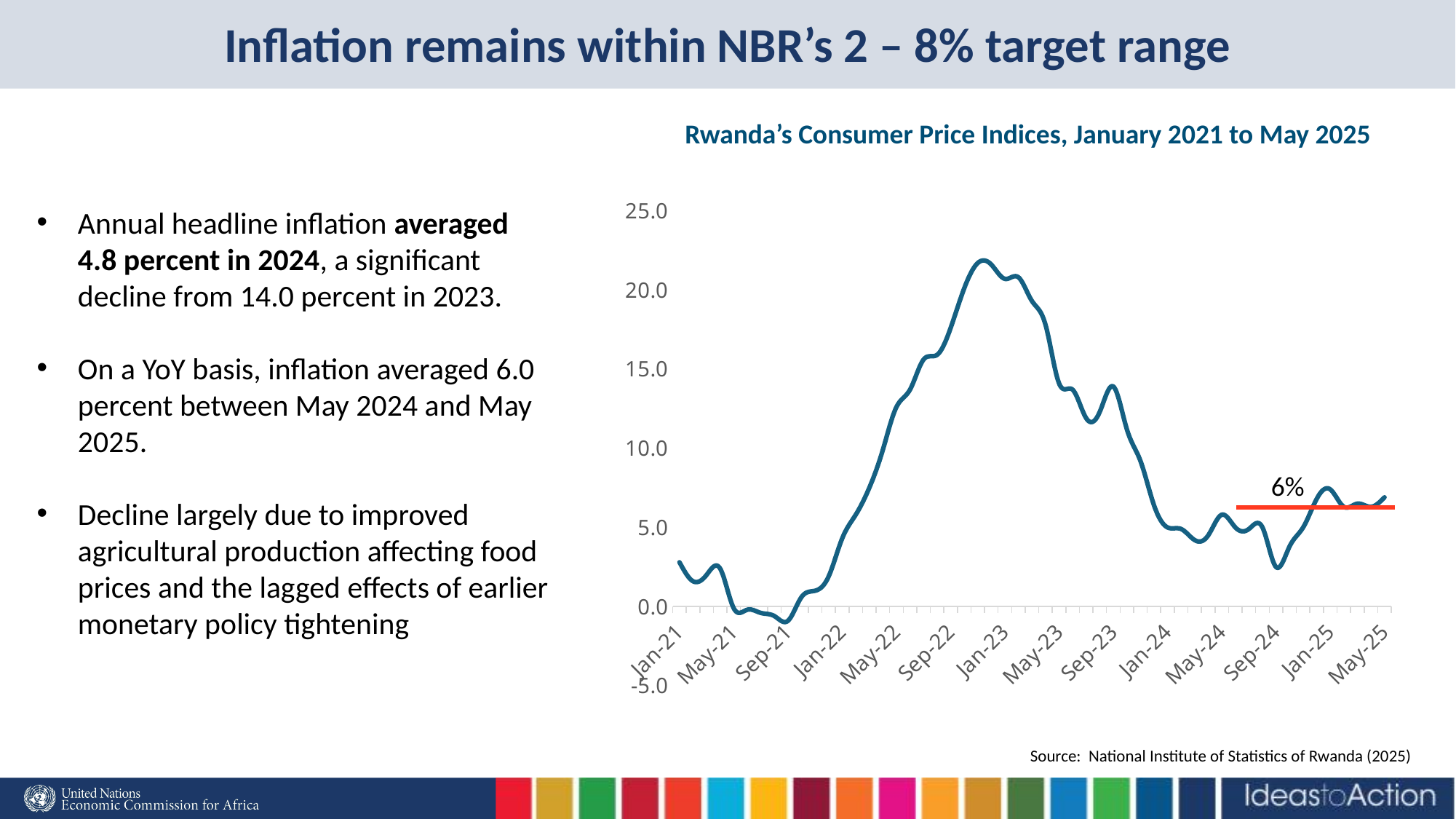
Is the value for Jan-23 greater or less than 20.0? greater Is the value for Jan-21 greater or less than 5.0? less Among the months labelled on the x axis, which has the lowest value? Sep-21 What value is labelled on the red horizontal reference line in the chart? 6% Is the value for May-23 greater or less than 10.0? greater What is the title of the chart? Rwanda's Consumer Price Indices, January 2021 to May 2025 Does the line rise or fall between Jan-23 and Jan-24? fall What kind of chart is shown on the slide? line chart Among the months labelled on the x axis, which has the highest value? Jan-23 How many month labels are shown on the x axis? 14